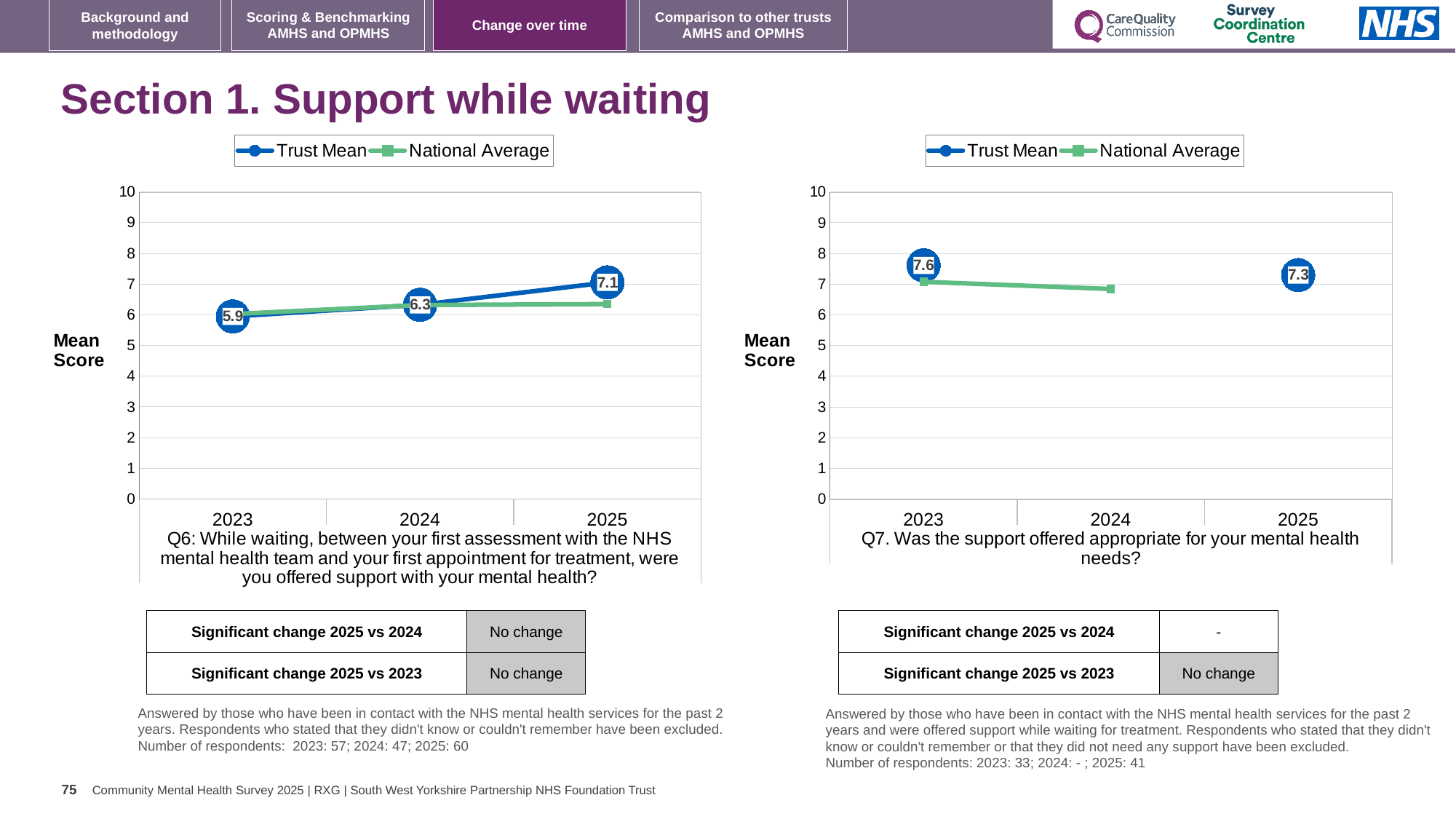
In the Q7 chart on the right, what is the Trust Mean for 2023? 7.6 In the Q6 chart on the left, which year has the highest Trust Mean? 2025 In the Q6 chart on the left, what is the Trust Mean for 2025? 7.1 In the Q7 chart on the right, what is the Trust Mean for 2025? 7.3 What type of chart is the Q6 chart on the left? line chart In the Q6 chart on the left, is the National Average for 2025 greater or less than 7? less In the Q6 chart on the left, what is the Trust Mean for 2023? 5.9 In the Q6 chart on the left, what is the difference between the Trust Mean for 2025 and 2023? 1.2 In the Q7 chart on the right, which is larger, the Trust Mean for 2023 or for 2025? 2023 How many series does the legend of the Q7 chart on the right list? 2 In the Q6 chart on the left, does the Trust Mean rise or fall from 2023 to 2025? rise In the Q7 chart on the right, is the National Average for 2024 greater or less than 6? greater